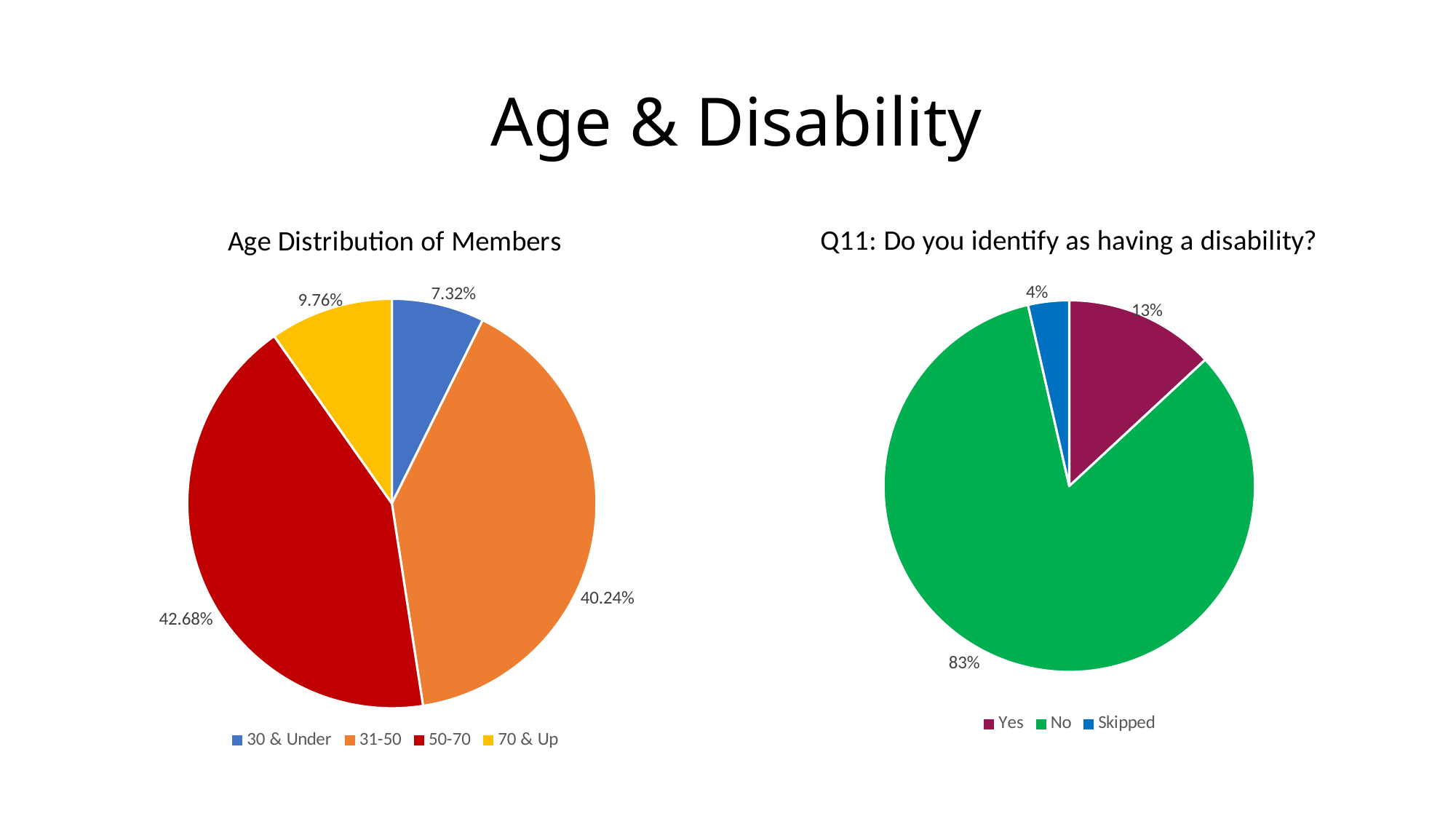
In the 'Q11: Do you identify as having a disability?' chart, which response has the smallest share? Skipped What kind of chart is 'Age Distribution of Members'? Pie chart In the 'Age Distribution of Members' chart, what is the difference between the 50-70 share and the 31-50 share? 2.44% In the 'Q11: Do you identify as having a disability?' chart, what percentage answered Yes? 13% In the 'Age Distribution of Members' chart, what share of members are 30 & Under? 7.32% In the 'Q11: Do you identify as having a disability?' chart, which is larger, Yes or Skipped? Yes In the 'Age Distribution of Members' chart, which age group has the largest share? 50-70 In the 'Age Distribution of Members' chart, what share of members are 31-50? 40.24% In the 'Age Distribution of Members' chart, which age group has the smallest share? 30 & Under In the 'Q11: Do you identify as having a disability?' chart, what percentage answered No? 83% In the 'Q11: Do you identify as having a disability?' chart, what colour is the No slice? Green In the 'Age Distribution of Members' chart, how many age groups are shown? 4